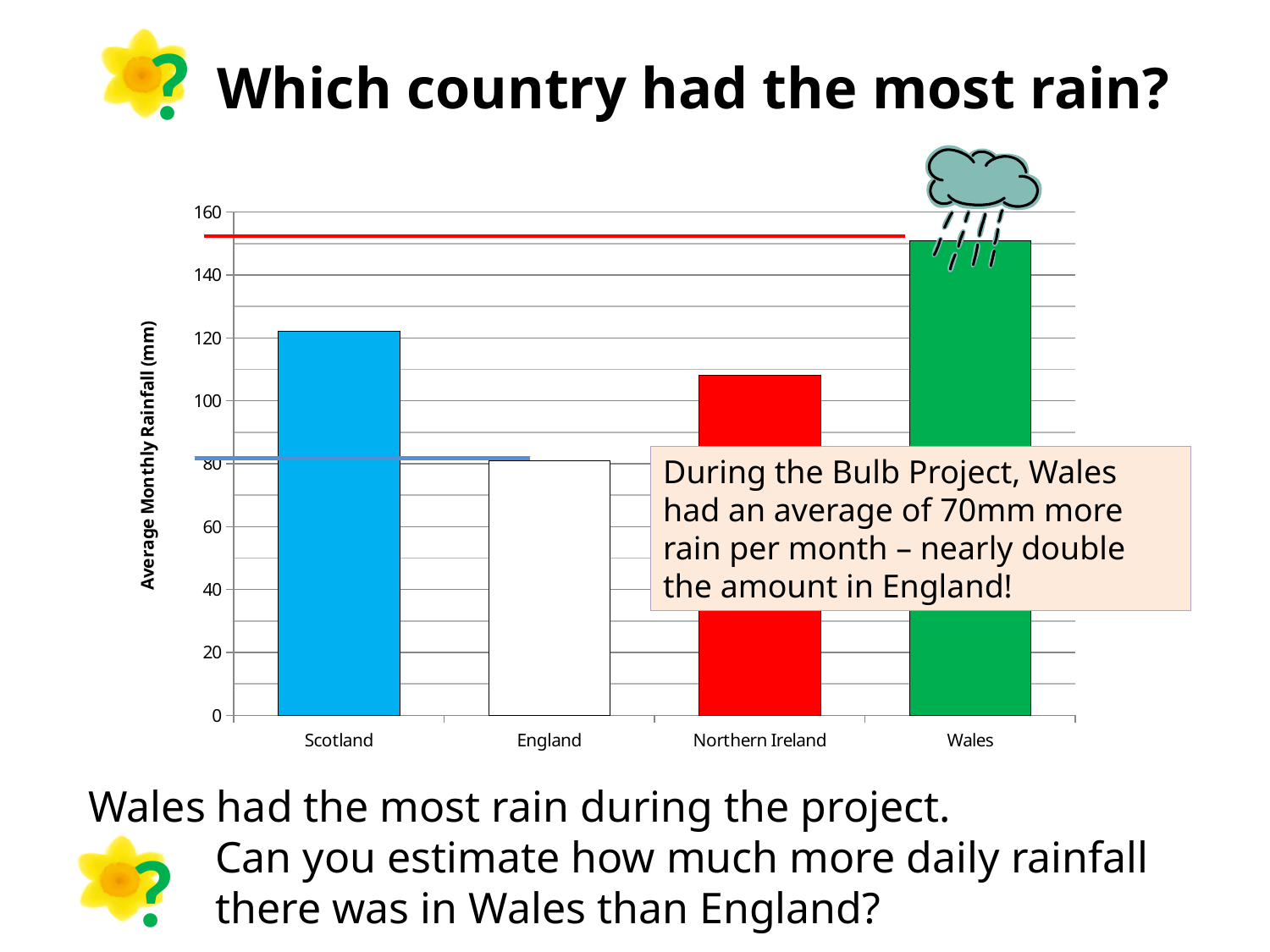
Which has the higher average monthly rainfall, Scotland or Northern Ireland? Scotland What is the label on the vertical axis of the chart? Average Monthly Rainfall (mm) Is the value for Scotland greater or less than 100? greater Is the value for Northern Ireland greater or less than 120? less How many countries are plotted on the chart? 4 Is the value for England greater or less than 100? less Which country has the highest average monthly rainfall on the chart? Wales Which has the higher average monthly rainfall, England or Northern Ireland? Northern Ireland What kind of chart is shown on the slide? bar chart Which country has the lowest average monthly rainfall on the chart? England What colour is the bar for Wales? green